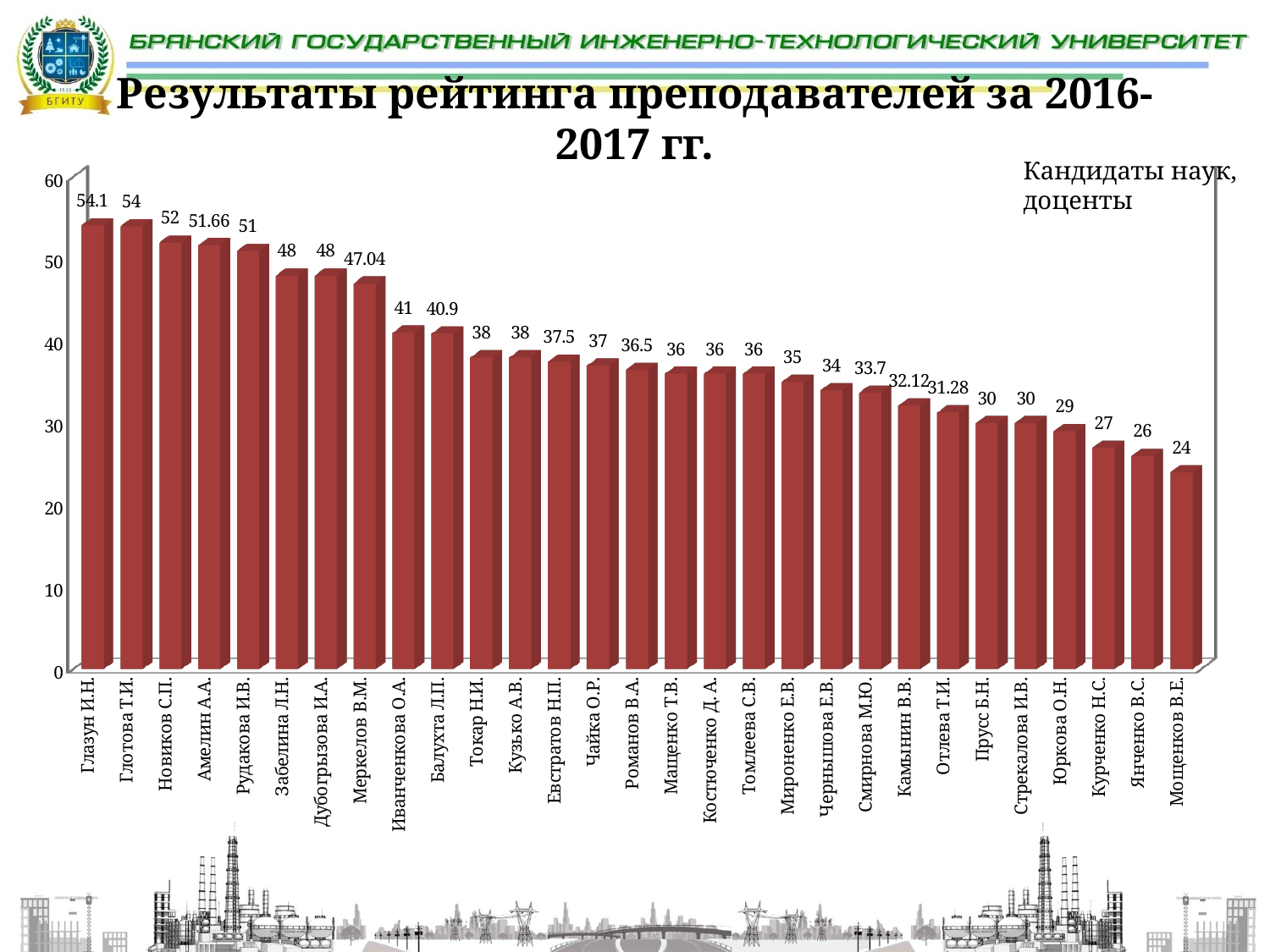
What is the value for Меркелов В.М.? 47.04 How many lecturers are shown on the chart? 29 Which lecturer has the lowest rating value? Мощенков В.Е. What is the value for Глазун И.Н.? 54.1 What is the value for Смирнова М.Ю.? 33.7 Which is larger, the value for Иванченкова О.А. or the value for Мироненко Е.В.? Иванченкова О.А. Which lecturer has the highest rating value? Глазун И.Н. What is the difference between the values for Новиков С.П. and Рудакова И.В.? 1 What is the difference between the values for Глазун И.Н. and Мощенков В.Е.? 30.1 What is the value for Камынин В.В.? 32.12 What kind of chart is shown on the slide? Bar chart Do the values rise or fall from left to right along the x axis? Fall